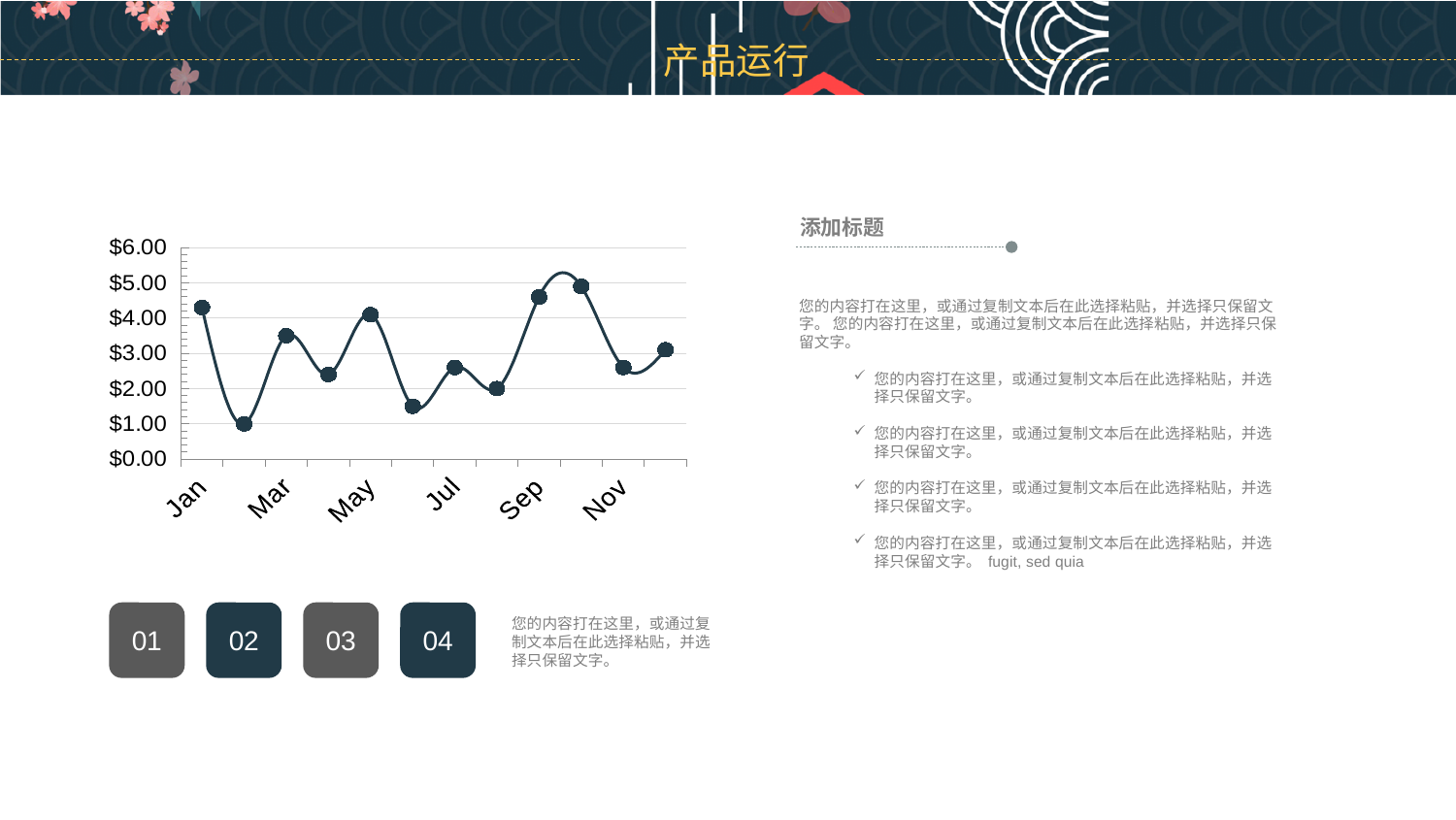
Is the value for May greater or less than $3.00? greater Which is larger, the value for Jan or the value for Mar? Jan What is the highest value shown on the y axis of the chart? $6.00 Is the value for Mar greater or less than $3.00? greater Is the value for Jan greater or less than $4.00? greater What kind of chart is shown on the slide? line chart How many data points are plotted on the line chart? 12 Does the line rise or fall from Sep to Nov? fall Which is larger, the value for Sep or the value for Nov? Sep